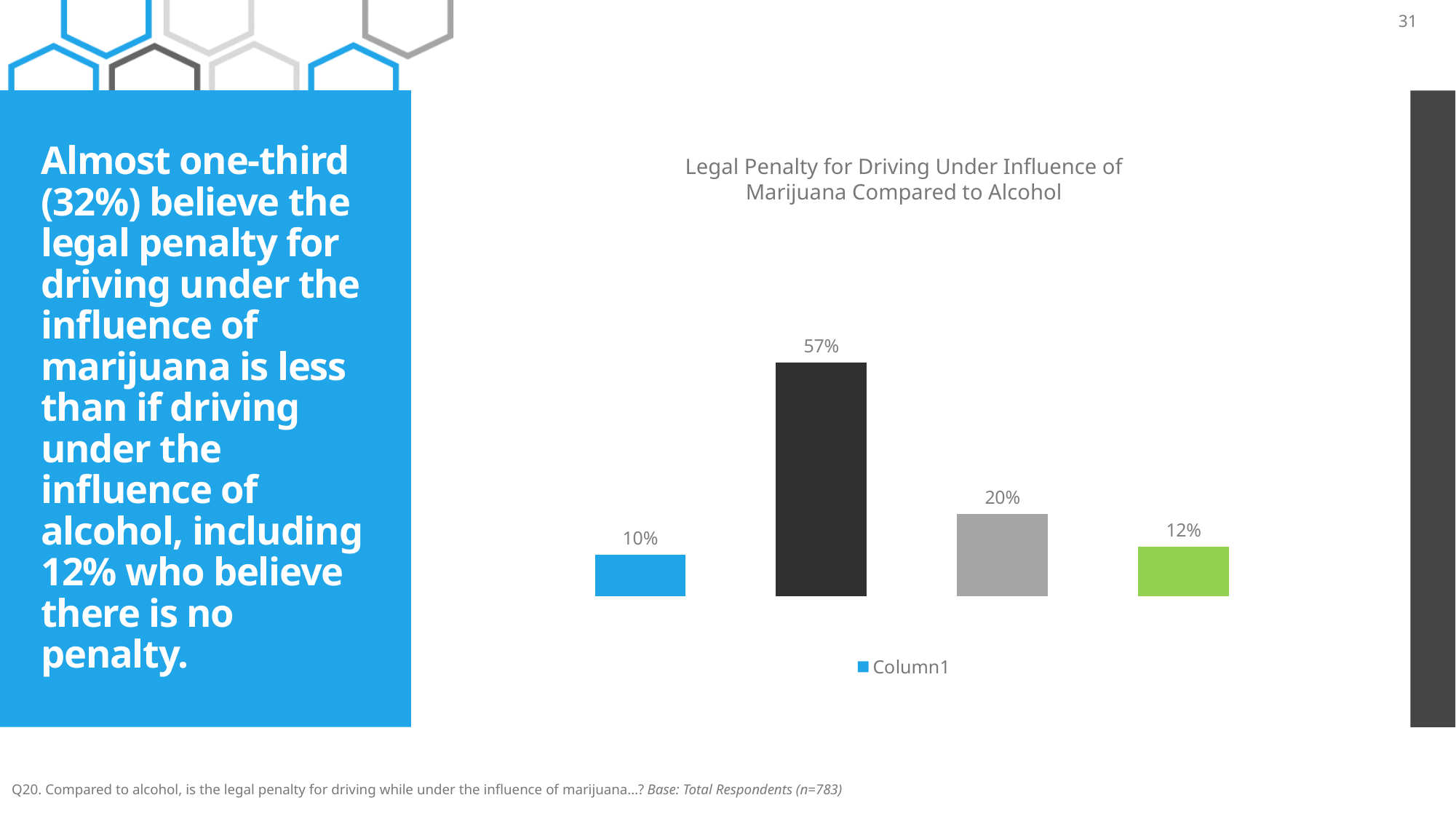
What value is shown on the third (gray) bar from the left? 20% What is the highest value shown in the chart? 57% What kind of chart is shown on the slide? bar chart How many series does the chart legend list? 1 What is the title of the chart? Legal Penalty for Driving Under Influence of Marijuana Compared to Alcohol What value is shown on the first (blue) bar from the left? 10% How many bars are plotted in the chart? 4 What is the legend entry shown below the chart? Column1 What is the difference between the value of the second (dark) bar and the third (gray) bar? 37% What is the lowest value shown in the chart? 10% What value is shown on the fourth (green) bar from the left? 12% What value is shown on the second (dark) bar from the left? 57%